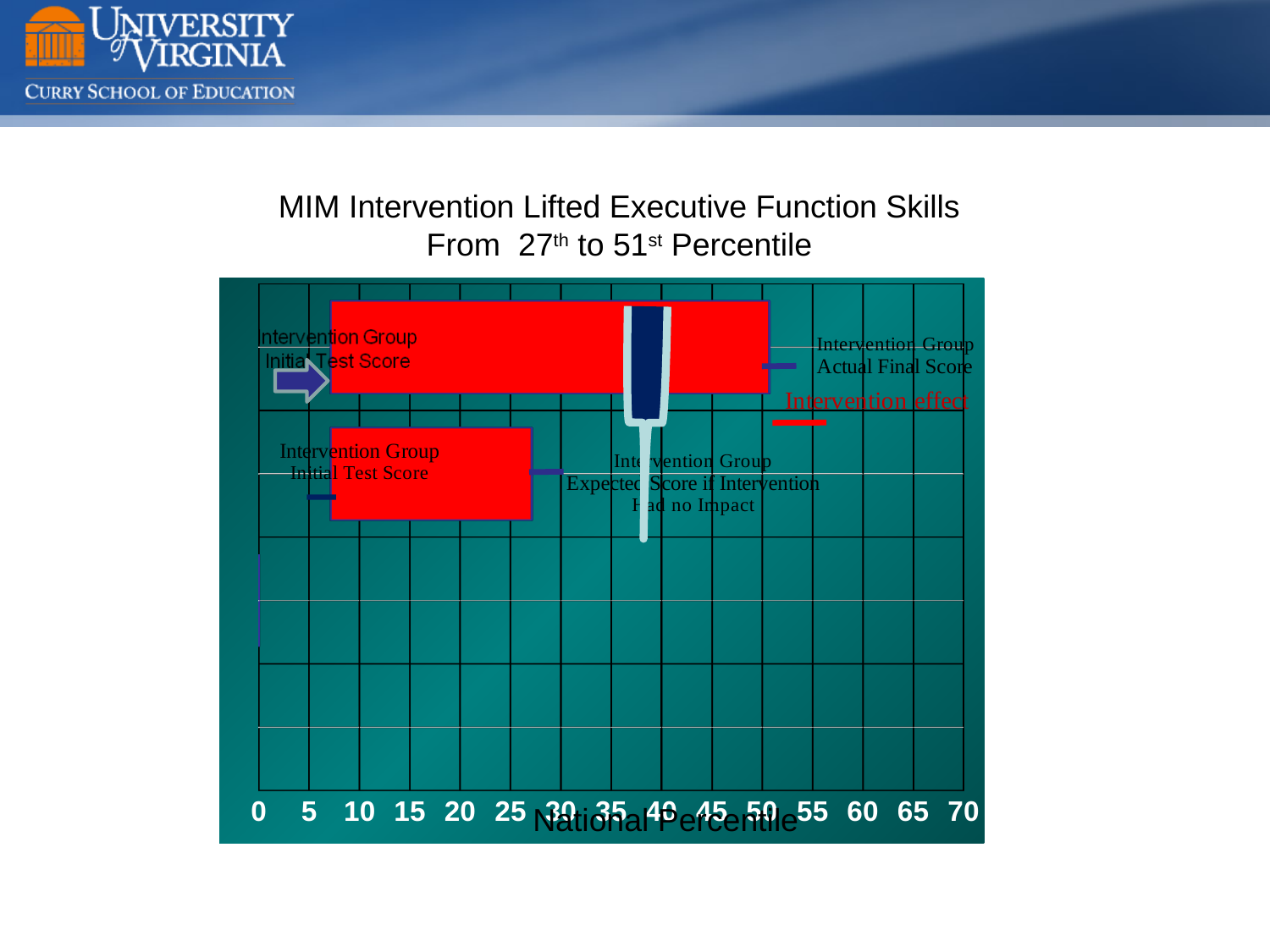
Is the value for the Intervention Group Expected Score if Intervention Had no Impact greater or less than 35? less Which bar in the chart is the longest? Intervention Group Actual Final Score Is the value for the Intervention Group Expected Score if Intervention Had no Impact greater or less than 20? greater How many bars are plotted in the chart? 2 What is the highest value labelled on the x axis? 70 Is the value for the Intervention Group Actual Final Score greater or less than 40? greater Which bar in the chart is the shortest? Intervention Group Expected Score if Intervention Had no Impact What kind of chart is shown on the slide? bar chart What is the title of the chart's x axis? National Percentile Which bar reaches a higher national percentile: the Actual Final Score or the Expected Score if Intervention Had no Impact? Actual Final Score According to the chart title, from which percentile to which percentile did the MIM intervention lift executive function skills? From 27th to 51st percentile